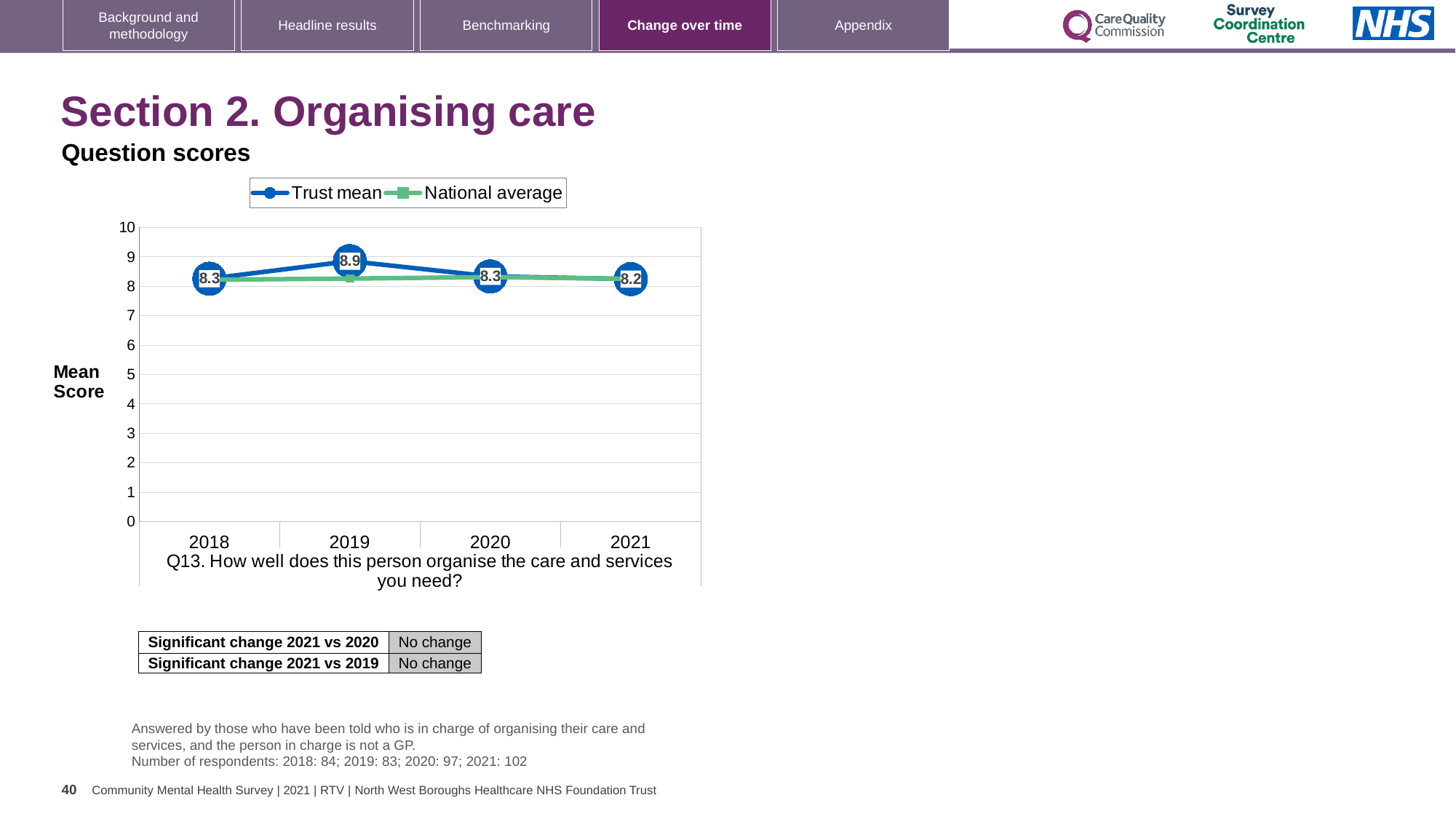
How many years are shown on the x axis? 4 In which year is the Trust mean lowest? 2021 What is the Trust mean for 2018? 8.3 In which year is the Trust mean highest? 2019 Which is larger, the Trust mean in 2019 or the Trust mean in 2021? 2019 What is the Trust mean for 2021? 8.2 Is the National average for 2019 greater or less than 5? greater How many series does the legend list? 2 What is the Trust mean for 2019? 8.9 What kind of chart is shown on the slide? line chart Does the Trust mean rise or fall from 2019 to 2021? fall What is the difference between the Trust mean in 2019 and the Trust mean in 2020? 0.6